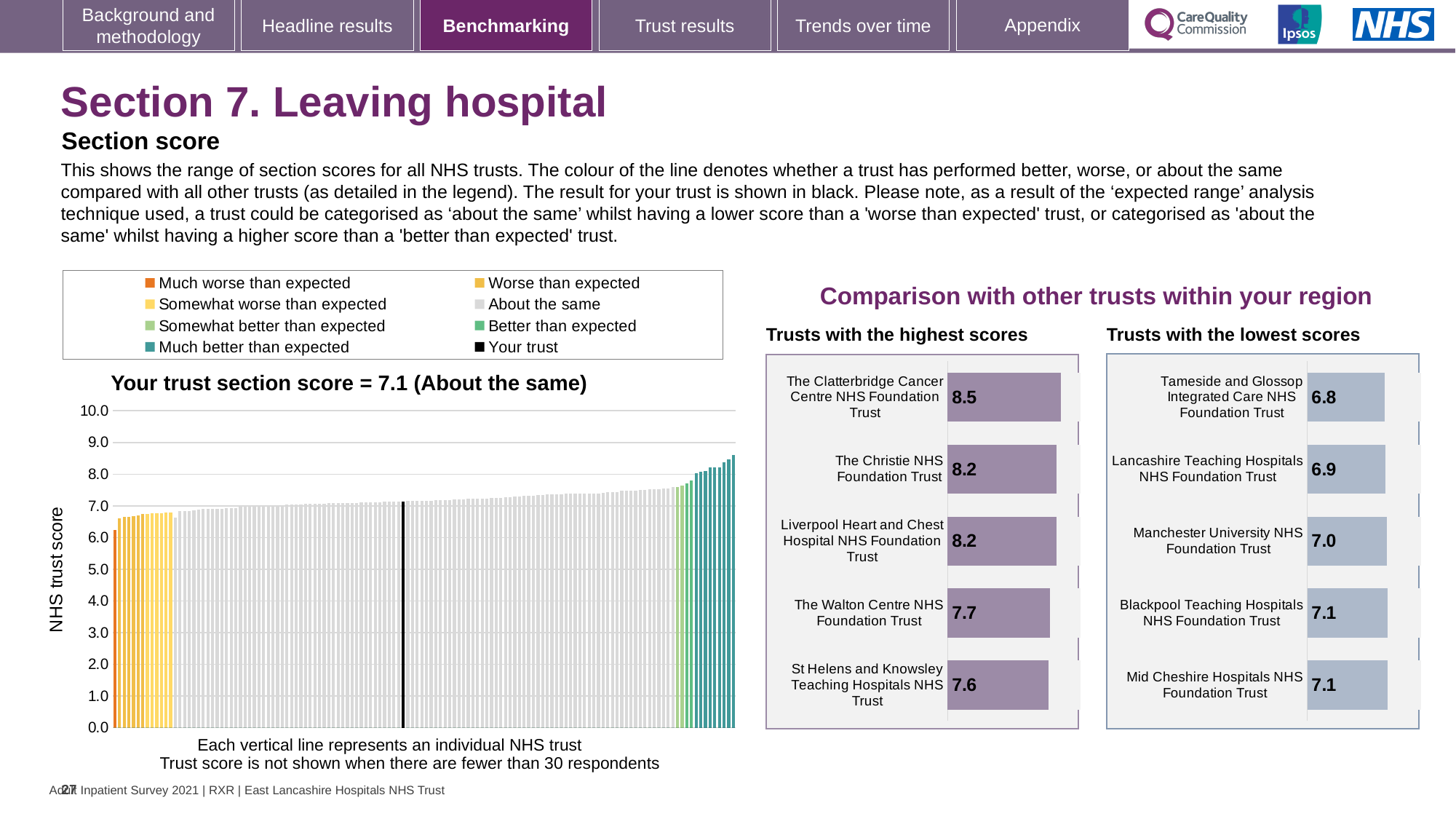
In the 'Your trust section score' chart, do the values rise or fall from left to right along the x axis? rise In the 'Your trust section score' chart, what is the section score for your trust? 7.1 In the 'Your trust section score' chart, what is the label on the vertical axis? NHS trust score In the 'Your trust section score' chart, is the value of the rightmost bar greater or less than 8.0? greater In the 'Trusts with the lowest scores' chart, how many trusts are shown? 5 In the 'Your trust section score' chart, what kind of chart is shown? bar chart In the 'Trusts with the lowest scores' chart, which trust has the lowest score? Tameside and Glossop Integrated Care NHS Foundation Trust In the 'Trusts with the highest scores' chart, which trust has the highest score? The Clatterbridge Cancer Centre NHS Foundation Trust In the 'Your trust section score' chart, how many entries does the legend list? 8 In the 'Trusts with the highest scores' chart, what is the score for The Walton Centre NHS Foundation Trust? 7.7 In the 'Trusts with the lowest scores' chart, which has the larger score: Tameside and Glossop Integrated Care NHS Foundation Trust or Manchester University NHS Foundation Trust? Manchester University NHS Foundation Trust In the 'Trusts with the highest scores' chart, what is the difference between the scores of The Clatterbridge Cancer Centre NHS Foundation Trust and St Helens and Knowsley Teaching Hospitals NHS Trust? 0.9